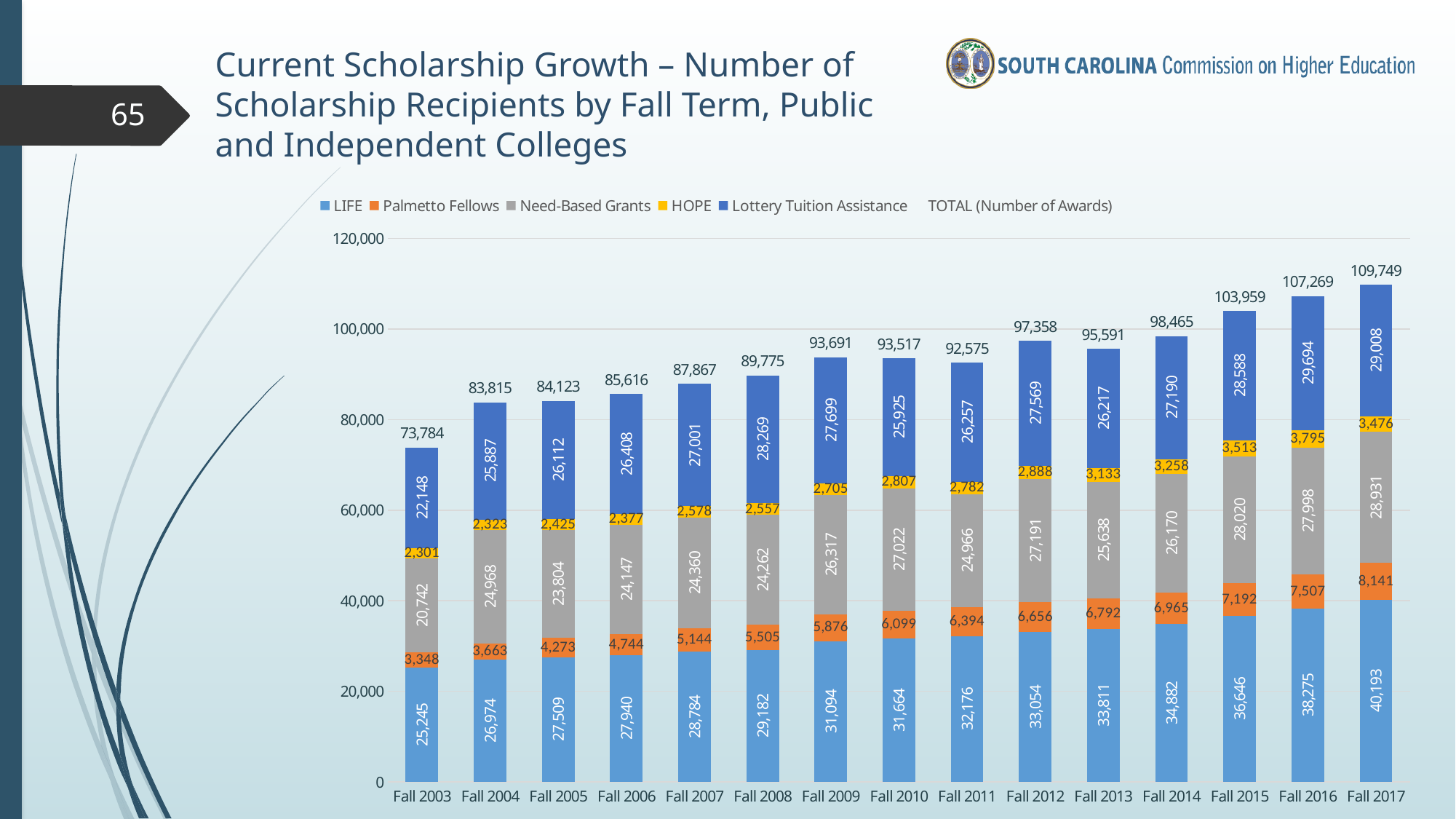
What is the Lottery Tuition Assistance value for Fall 2008? 28,269 What is the HOPE value for Fall 2014? 3,258 What is the LIFE value for Fall 2017? 40,193 What is the Need-Based Grants value for Fall 2010? 27,022 Which is larger, the Lottery Tuition Assistance value for Fall 2016 or for Fall 2017? Fall 2016 How many fall terms are shown on the x axis? 15 What kind of chart is shown on the slide? Stacked bar chart Which fall term has the highest total number of awards? Fall 2017 What is the total number of awards for Fall 2012? 97,358 What is the difference between the LIFE value for Fall 2017 and Fall 2003? 14,948 Which fall term has the lowest Palmetto Fellows value? Fall 2003 How many entries does the legend list? 6